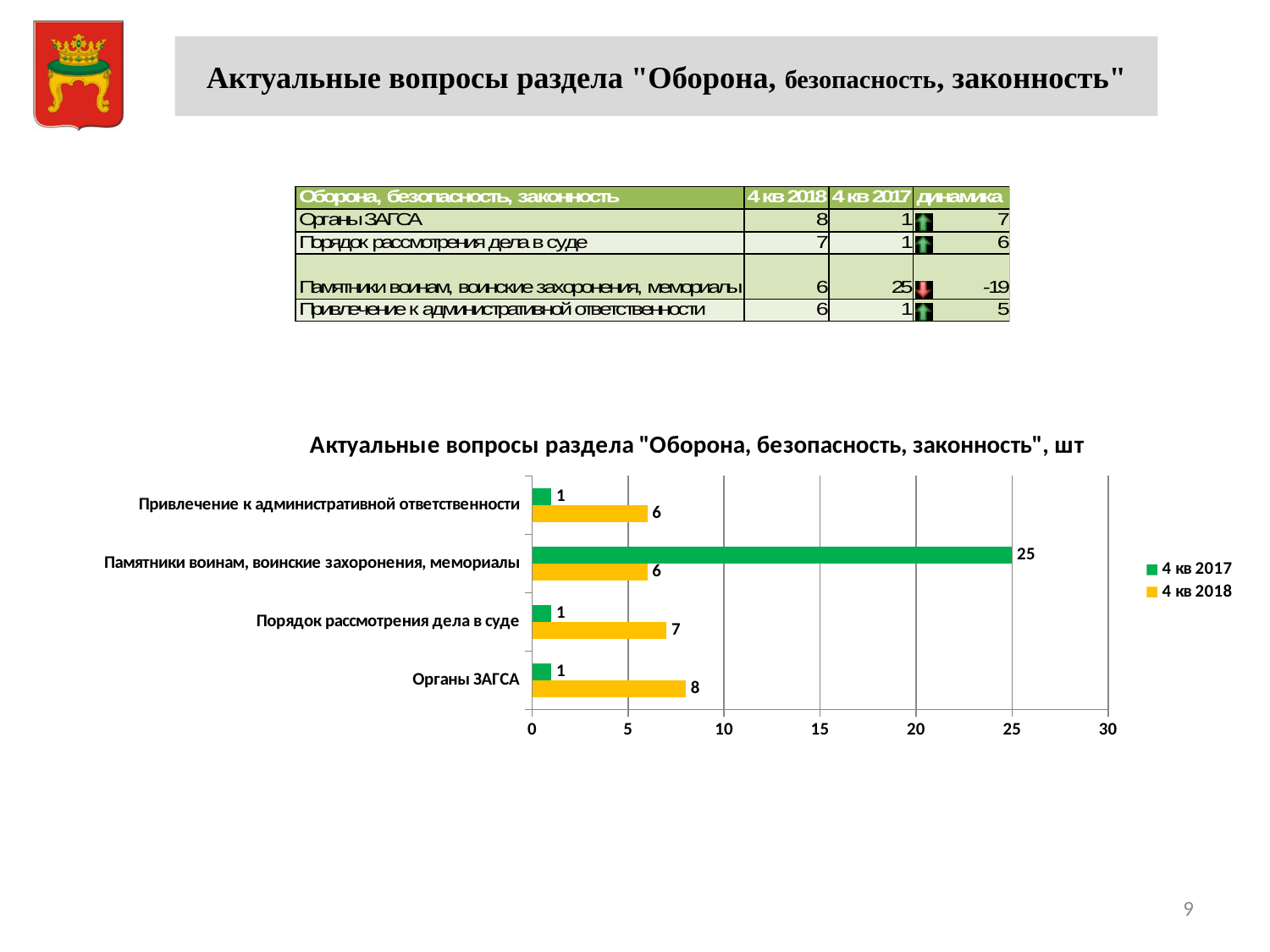
How many series does the legend list? 2 How many categories are shown on the chart? 4 What is the title of the chart? Актуальные вопросы раздела "Оборона, безопасность, законность", шт What is the value for "Порядок рассмотрения дела в суде" in the "4 кв 2018" series? 7 What is the difference between the "4 кв 2017" and "4 кв 2018" values for "Памятники воинам, воинские захоронения, мемориалы"? 19 What is the value for "Органы ЗАГСА" in the "4 кв 2018" series? 8 Which category has the highest value in the "4 кв 2018" series? Органы ЗАГСА Which category has the highest value in the "4 кв 2017" series? Памятники воинам, воинские захоронения, мемориалы What is the difference between the "4 кв 2018" and "4 кв 2017" values for "Органы ЗАГСА"? 7 What kind of chart is shown on the slide? Bar chart For "Привлечение к административной ответственности", which series has the larger value, "4 кв 2017" or "4 кв 2018"? 4 кв 2018 What is the value for "Памятники воинам, воинские захоронения, мемориалы" in the "4 кв 2017" series? 25